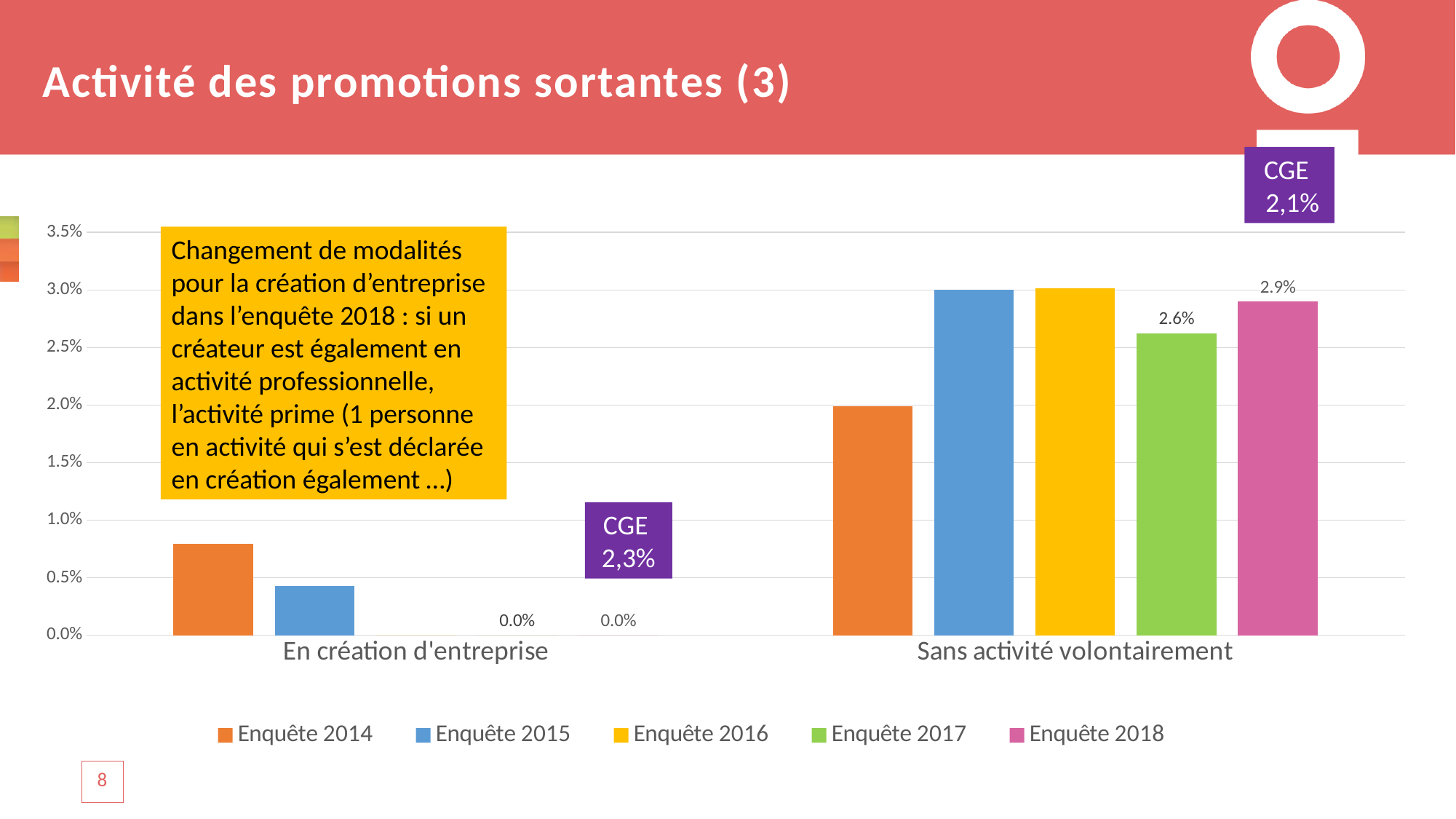
Is the value for Enquête 2014 in the 'Sans activité volontairement' category greater or less than 2.5%? less What kind of chart is shown on the slide? bar chart How many categories are shown on the x axis? 2 What is the value for Enquête 2018 in the 'Sans activité volontairement' category? 2.9% Is the value for Enquête 2015 in the 'Sans activité volontairement' category greater or less than 2.5%? greater Which series has the lowest value in the 'Sans activité volontairement' category? Enquête 2014 What is the difference between the Enquête 2018 and Enquête 2017 values in the 'Sans activité volontairement' category? 0.3% How many series does the legend list? 5 Is the value for Enquête 2014 in the 'En création d'entreprise' category greater or less than 1.0%? less What is the value for Enquête 2018 in the 'En création d'entreprise' category? 0.0% In the 'Sans activité volontairement' category, which is larger: Enquête 2017 or Enquête 2018? Enquête 2018 What is the value for Enquête 2017 in the 'Sans activité volontairement' category? 2.6%